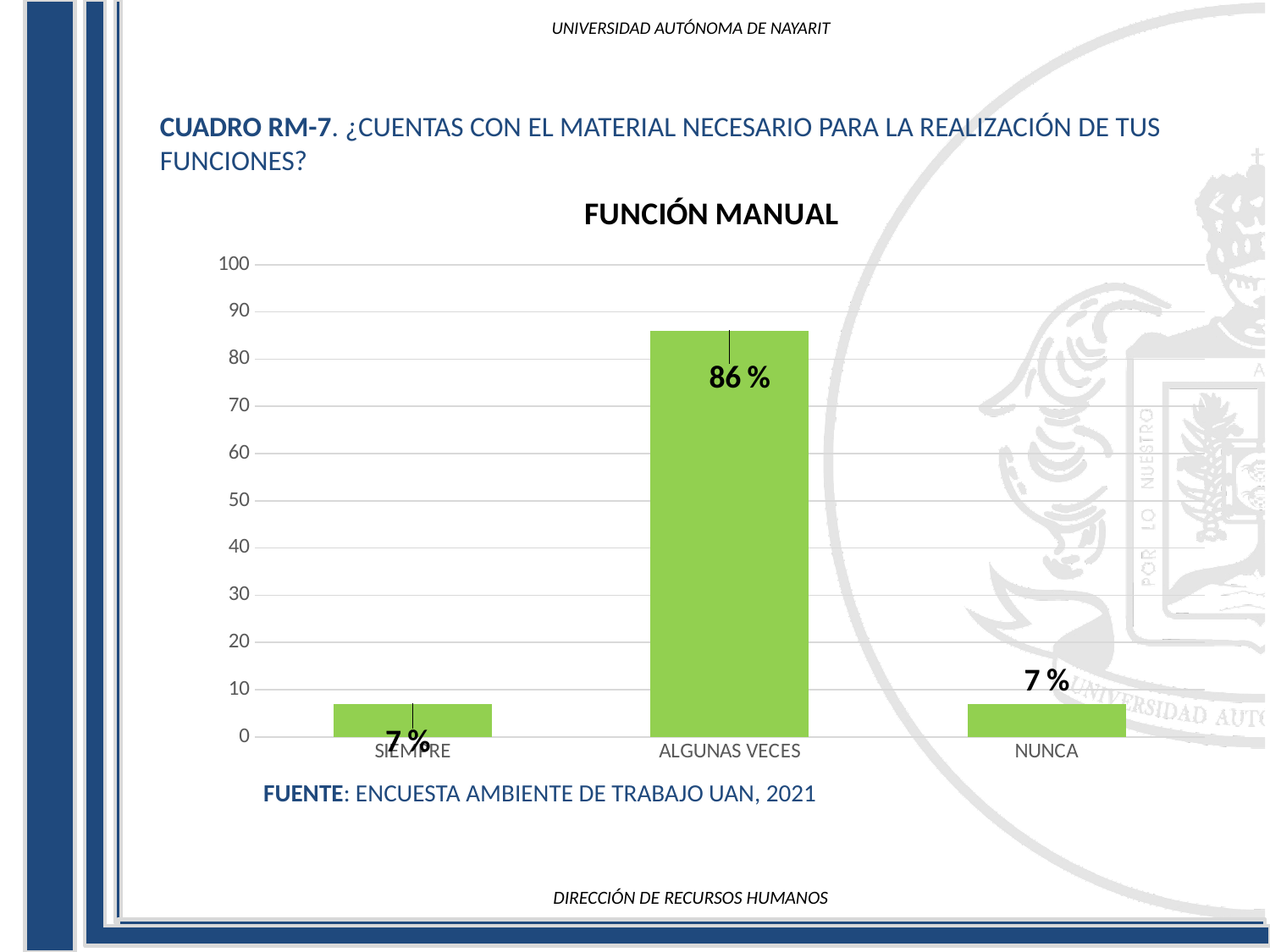
What is the value for NUNCA? 7 % Is the value for NUNCA greater or less than 10? less What kind of chart is shown? bar chart What is the value for ALGUNAS VECES? 86 % Which is larger, the value for ALGUNAS VECES or the value for SIEMPRE? ALGUNAS VECES Is the value for ALGUNAS VECES greater or less than 80? greater What is the highest value shown on the y axis? 100 How many categories are shown on the x axis? 3 What is the difference between the values for ALGUNAS VECES and NUNCA? 79 % What is the value for SIEMPRE? 7 % What is the title of the chart? FUNCIÓN MANUAL Which category has the highest value? ALGUNAS VECES